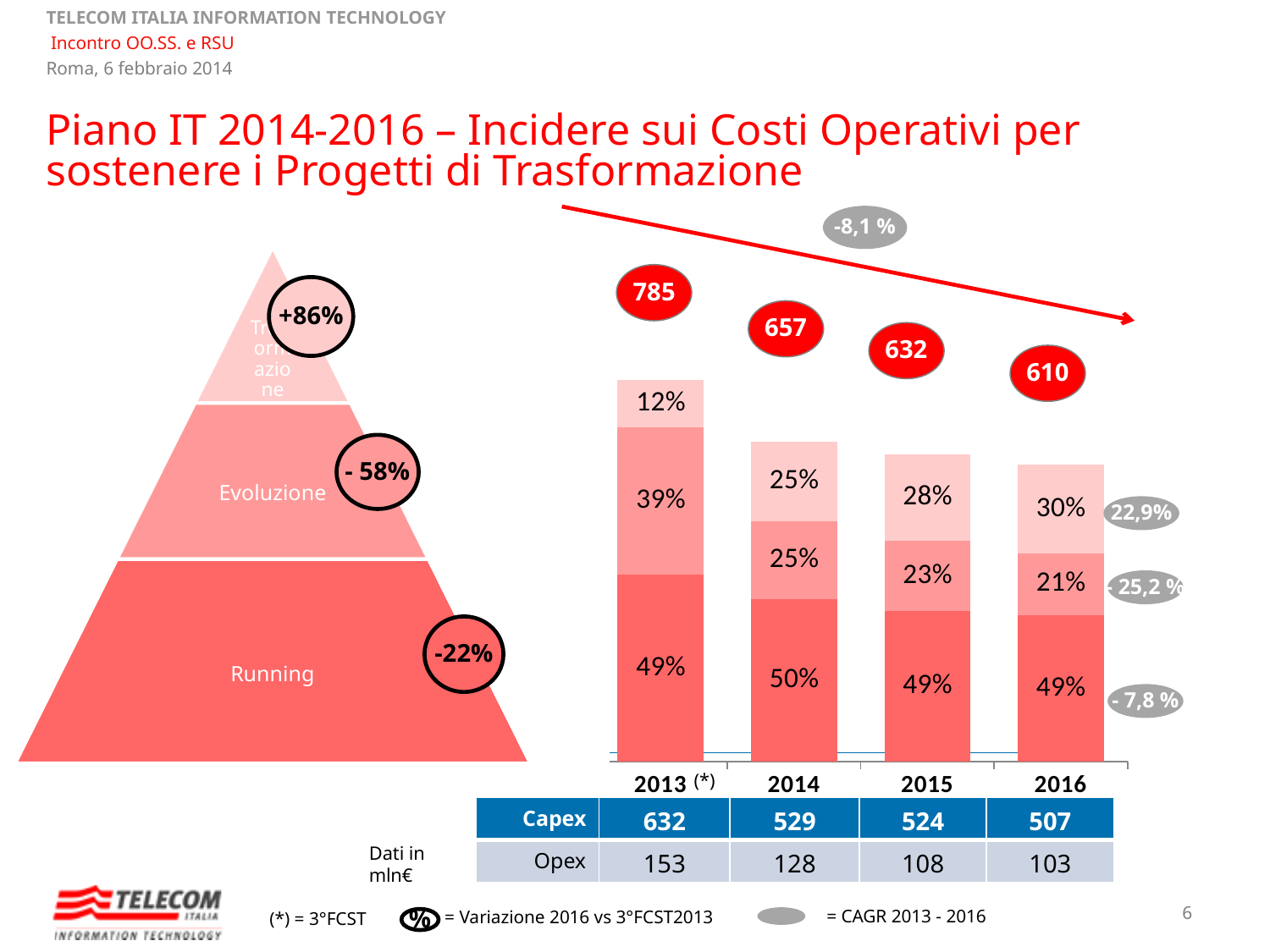
What percentage does the bottom segment of the 2014 bar show? 50% What is the total value shown above the bar for 2016 in the stacked bar chart? 610 What is the difference between the total values for 2013 and 2016 in the stacked bar chart? 175 What CAGR 2013-2016 is shown in the grey oval above the stacked bar chart? -8,1 % Which year has the highest total value in the stacked bar chart? 2013 Do the total values above the bars rise or fall from 2013 to 2016? fall How many years (categories) are shown on the x axis of the stacked bar chart? 4 What percentage does the top segment of the 2016 bar show? 30% What percentage does the middle segment of the 2013 bar show? 39% What kind of chart is shown on the right side of the slide? stacked bar chart What is the total value shown above the bar for 2013 in the stacked bar chart? 785 Which year has the lowest total value in the stacked bar chart? 2016